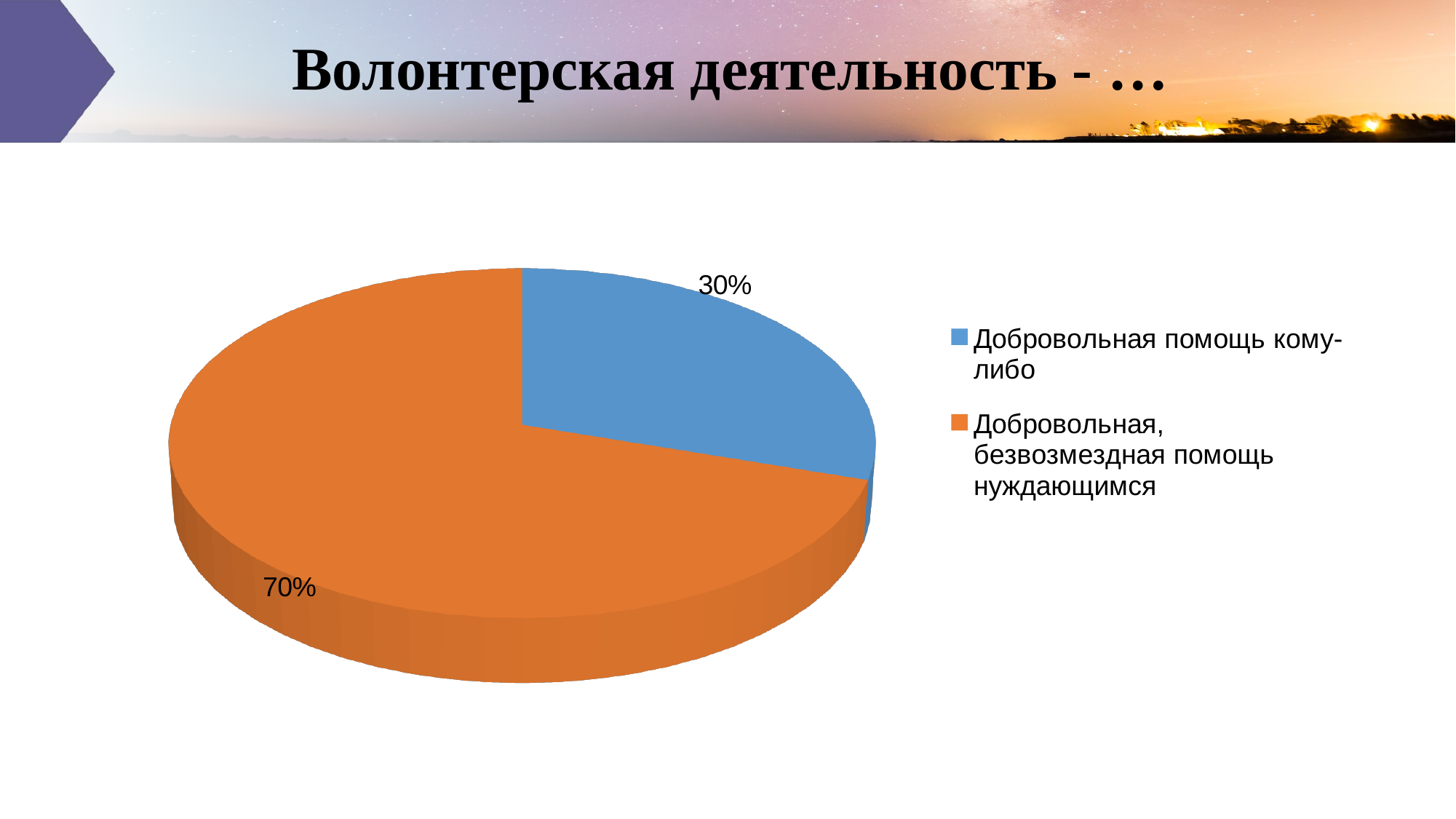
What share of the pie does "Добровольная, безвозмездная помощь нуждающимся" have? 70% Which is larger: the share for "Добровольная помощь кому-либо" or the share for "Добровольная, безвозмездная помощь нуждающимся"? Добровольная, безвозмездная помощь нуждающимся What colour is the slice for "Добровольная, безвозмездная помощь нуждающимся"? orange What kind of chart is shown on the slide? pie chart How many entries does the legend list? 2 Which slice of the pie is the smallest? Добровольная помощь кому-либо What share of the pie does "Добровольная помощь кому-либо" have? 30% Which slice of the pie is the largest? Добровольная, безвозмездная помощь нуждающимся What is the difference in percentage points between the two slices of the pie? 40 How many slices does the pie chart have? 2 What colour is the slice for "Добровольная помощь кому-либо"? blue